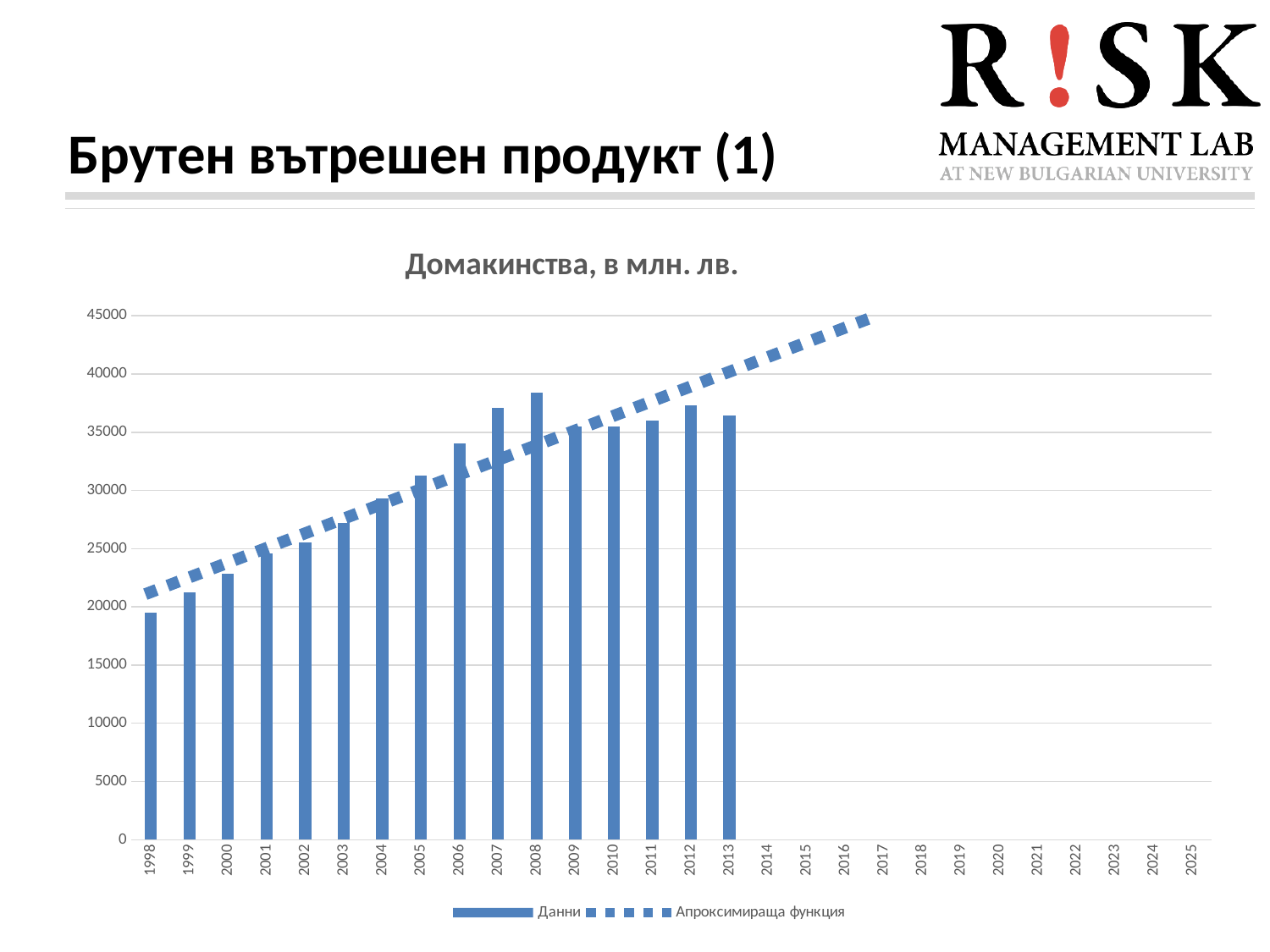
What kind of chart is shown on the slide? bar chart What is the title of the chart? Домакинства, в млн. лв. Which is larger, the bar for 2008 or the bar for 2013? 2008 Which year has the lowest bar? 1998 Is the value for 1998 greater or less than 20000? less Is the value for 2004 greater or less than 30000? less Is the value for 2008 greater or less than 35000? greater What are the two entries in the chart legend? Данни and Апроксимираща функция Which year has the highest bar? 2008 How many series does the legend list? 2 How many years have a bar plotted in the chart? 16 Do the bars generally rise or fall from 1998 to 2008? rise